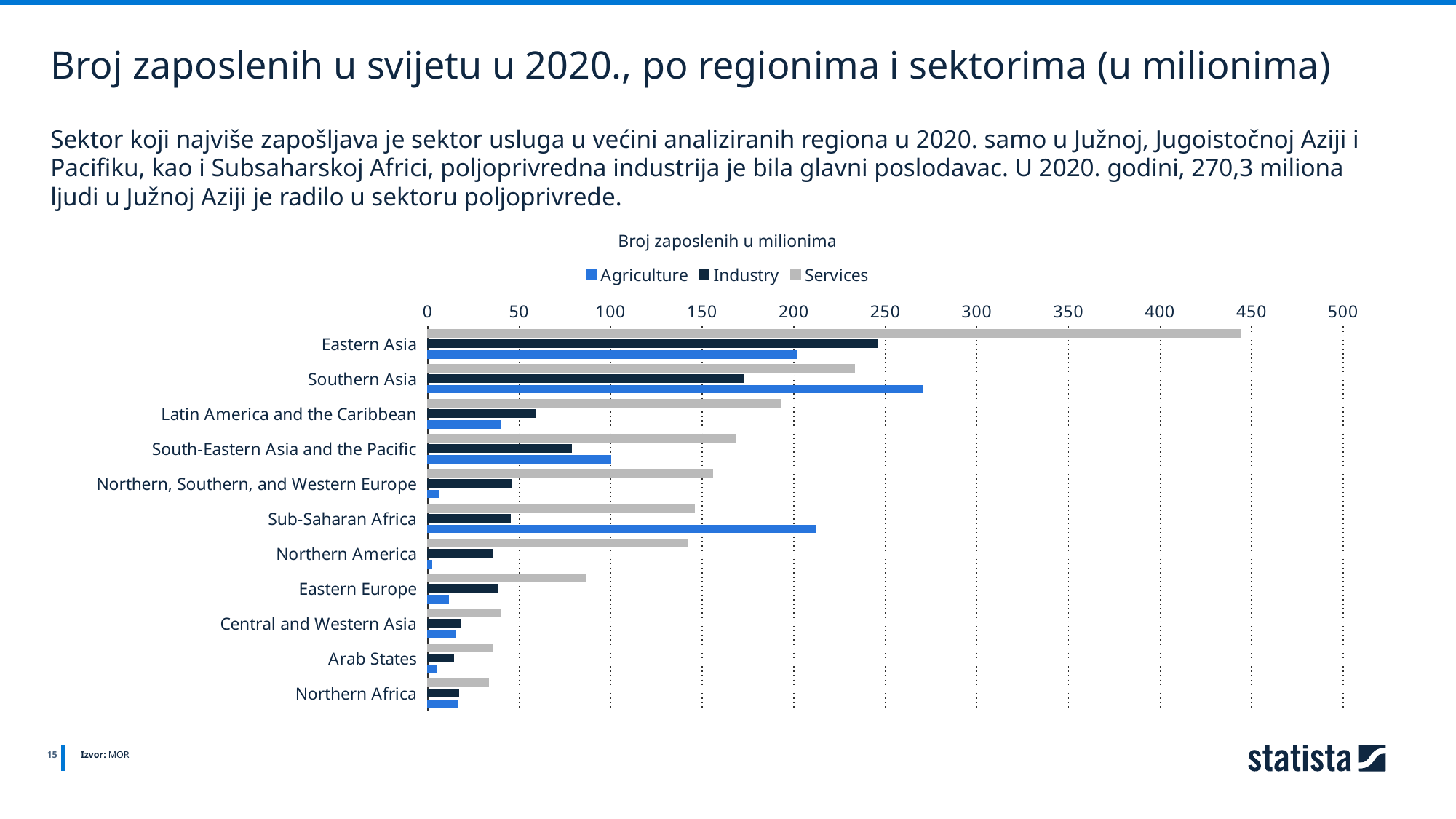
Which region has the highest Agriculture value? Southern Asia What kind of chart is shown on the slide? Bar chart Which region has the highest Services value? Eastern Asia How many series does the legend list? 3 Is the Services value for Eastern Asia greater or less than 400? greater Which is larger, the Industry value for Eastern Asia or the Industry value for Southern Asia? Eastern Asia Which colour represents the Services series in the legend? Grey Is the Services value for Eastern Europe greater or less than 100? less Which region has the lowest Agriculture value? Northern America Is the Agriculture value for Southern Asia greater or less than 250? greater How many regions are shown on the chart? 11 Which region has the highest Industry value? Eastern Asia